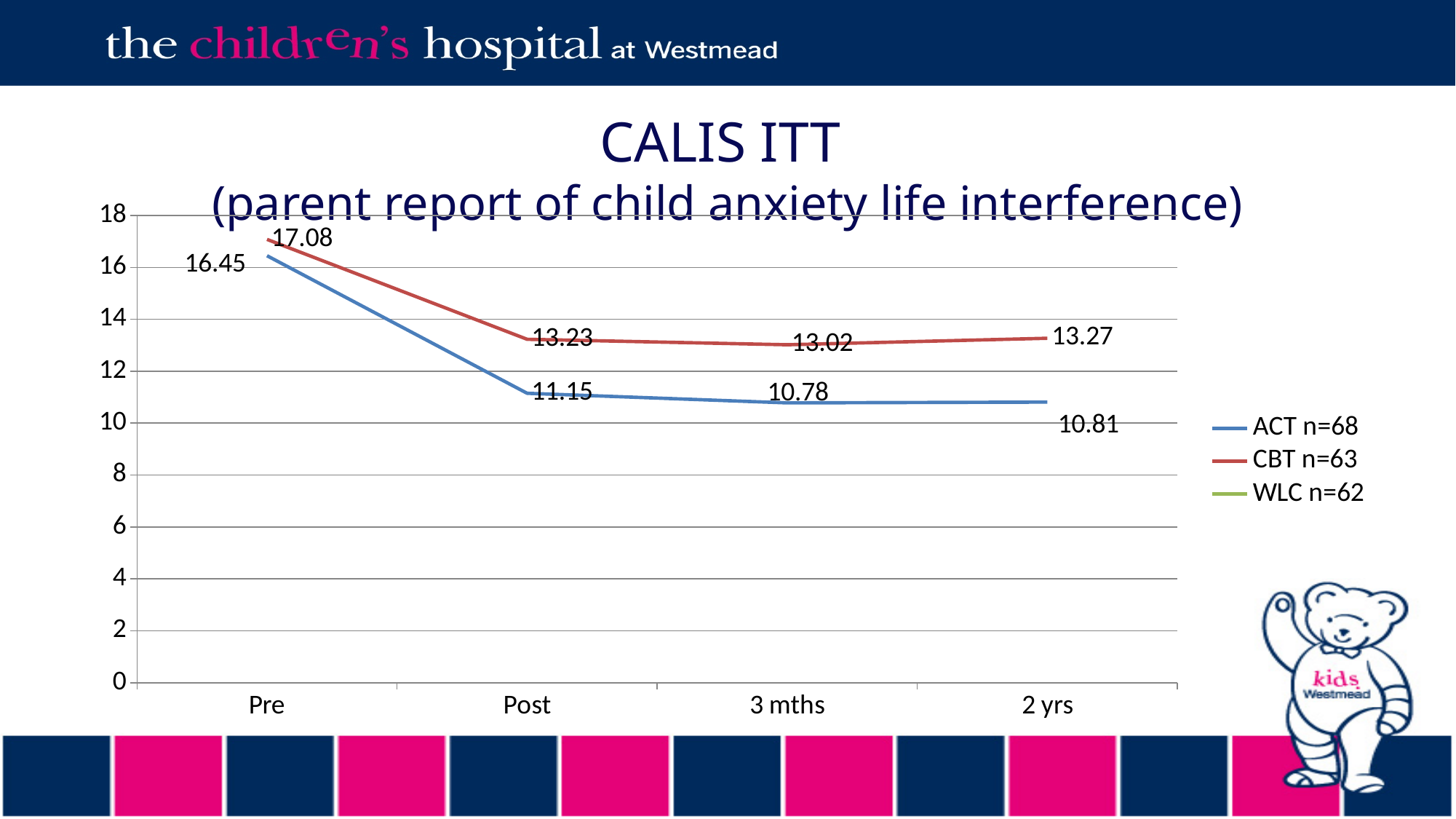
At which time point is the CBT n=63 value highest? Pre What type of chart is shown on the slide? Line chart Does the ACT n=68 line rise or fall from Pre to Post? Fall What is the value for ACT n=68 at Pre? 16.45 How many time points are shown on the x axis? 4 What is the value for ACT n=68 at 3 mths? 10.78 What is the difference between the CBT n=63 and ACT n=68 values at Post? 2.08 How many series does the legend list? 3 What is the value for CBT n=63 at 2 yrs? 13.27 At which time point is the ACT n=68 value lowest? 3 mths What is the value for CBT n=63 at Post? 13.23 Which series has the larger value at 2 yrs, ACT n=68 or CBT n=63? CBT n=63